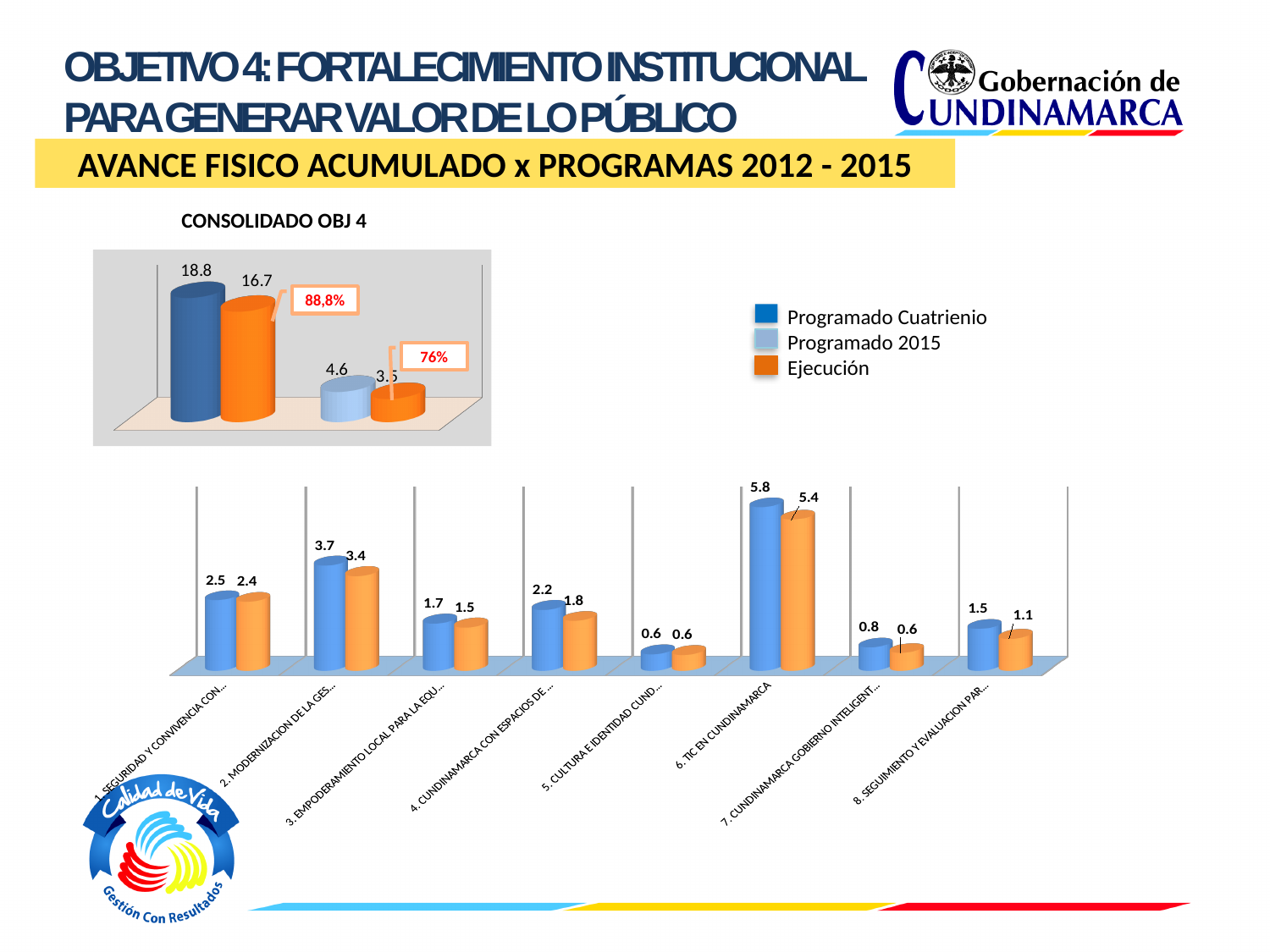
In the bottom chart, what is the value of the orange bar for 6. TIC EN CUNDINAMARCA? 5.4 In the CONSOLIDADO OBJ 4 chart, what is the difference between the Programado Cuatrienio value (18.8) and the Ejecución value next to it (16.7)? 2.1 In the bottom chart, how many program categories are shown on the x axis? 8 In the bottom chart, which has the larger blue bar: category 1. SEGURIDAD Y CONVIVENCIA or category 4. CUNDINAMARCA CON ESPACIOS? 1. SEGURIDAD Y CONVIVENCIA In the bottom chart, what is the difference between the blue bar (3.7) and the orange bar (3.4) for category 2. MODERNIZACION DE LA GES...? 0.3 In the bottom chart, which category has the lowest blue bar? 5. CULTURA E IDENTIDAD CUND... In the CONSOLIDADO OBJ 4 chart, what is the value of the Programado 2015 bar? 4.6 In the CONSOLIDADO OBJ 4 chart, what percentage is shown in the callout next to the 16.7 bar? 88,8% What kind of chart is the bottom chart on the slide? Bar chart In the bottom chart, which category has the highest blue bar? 6. TIC EN CUNDINAMARCA How many series does the legend on the slide list? 3 In the CONSOLIDADO OBJ 4 chart, what is the value of the Programado Cuatrienio bar? 18.8